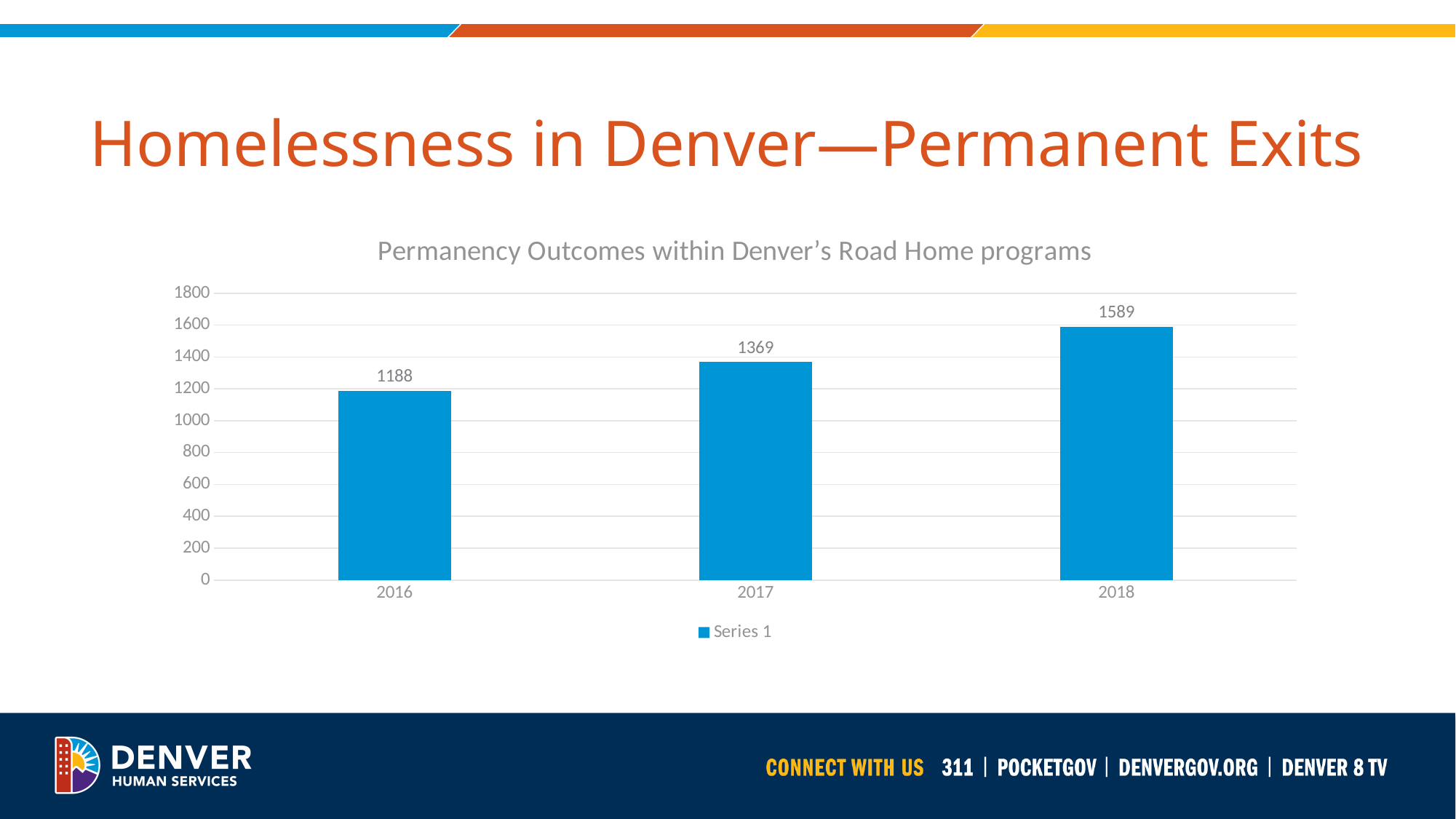
How many years are shown on the x axis? 3 What is the difference between the values for 2017 and 2016? 181 Which year has the lowest value? 2016 What is the difference between the values for 2018 and 2016? 401 What kind of chart is shown on the slide? bar chart What is the value for 2016? 1188 What is the value for 2017? 1369 What is the value for 2018? 1589 Do the values rise or fall from 2016 to 2018? rise Which year has the highest value? 2018 Which is larger, the value for 2017 or the value for 2018? 2018 Is the value for 2017 greater or less than 1400? less